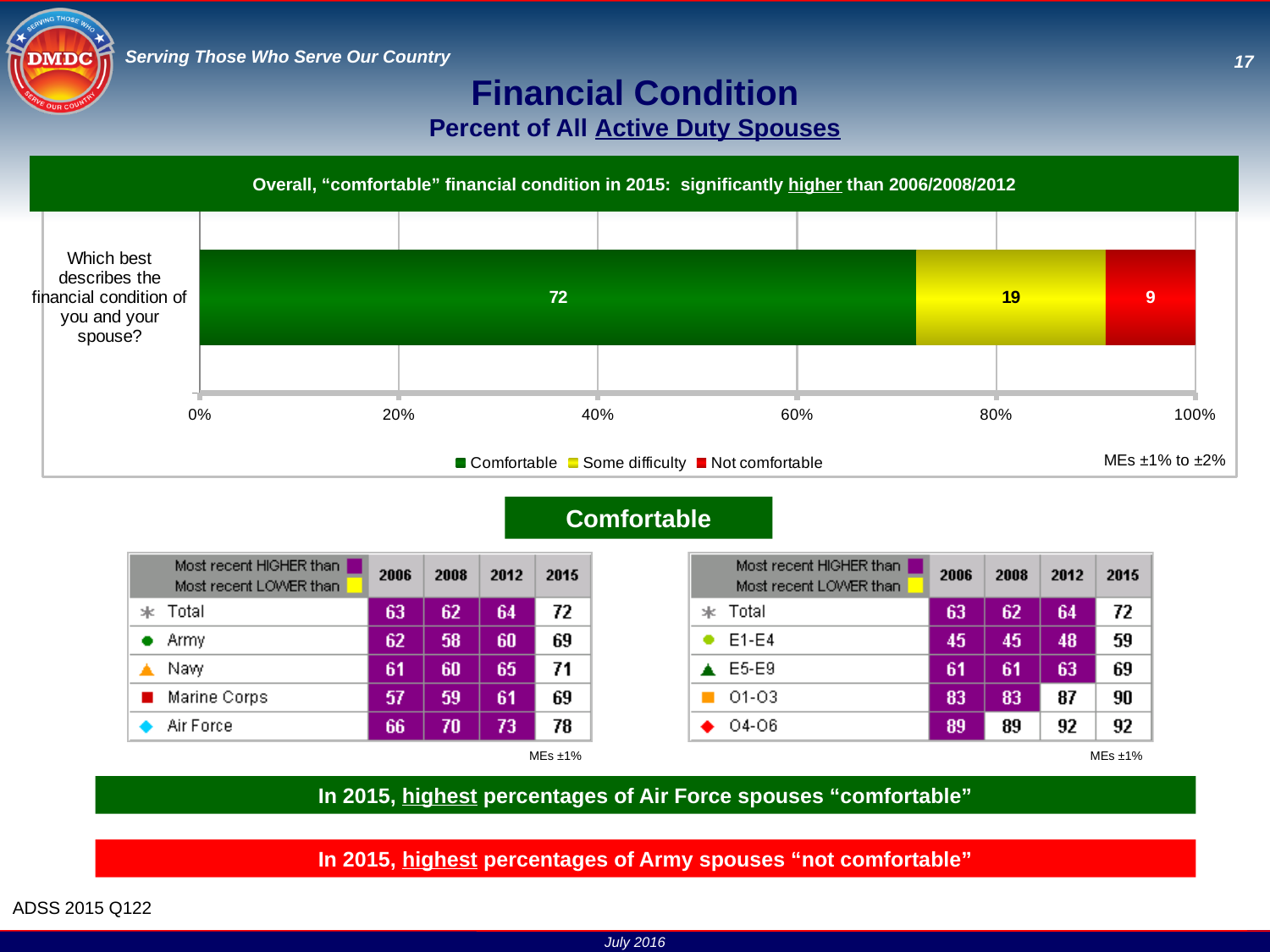
Is the "Comfortable" value in the stacked bar chart greater or less than 60%? greater How many series does the legend of the stacked bar chart list? 3 In the stacked bar chart, how many percentage points larger is the "Comfortable" segment than the "Some difficulty" segment? 53 Which response category has the smallest segment in the stacked bar chart? Not comfortable Which response category has the largest segment in the stacked bar chart? Comfortable In the stacked bar chart, what percentage of active duty spouses reported being "Comfortable"? 72 In the stacked bar chart, what percentage of active duty spouses reported being "Not comfortable"? 9 What is the total of the three segments in the stacked bar? 100 What kind of chart is used to show the financial condition responses? Stacked bar chart In the stacked bar chart, which is larger: "Some difficulty" or "Not comfortable"? Some difficulty In the stacked bar chart, what percentage of active duty spouses reported "Some difficulty"? 19 In the stacked bar chart, what is the difference between the "Some difficulty" and "Not comfortable" values? 10